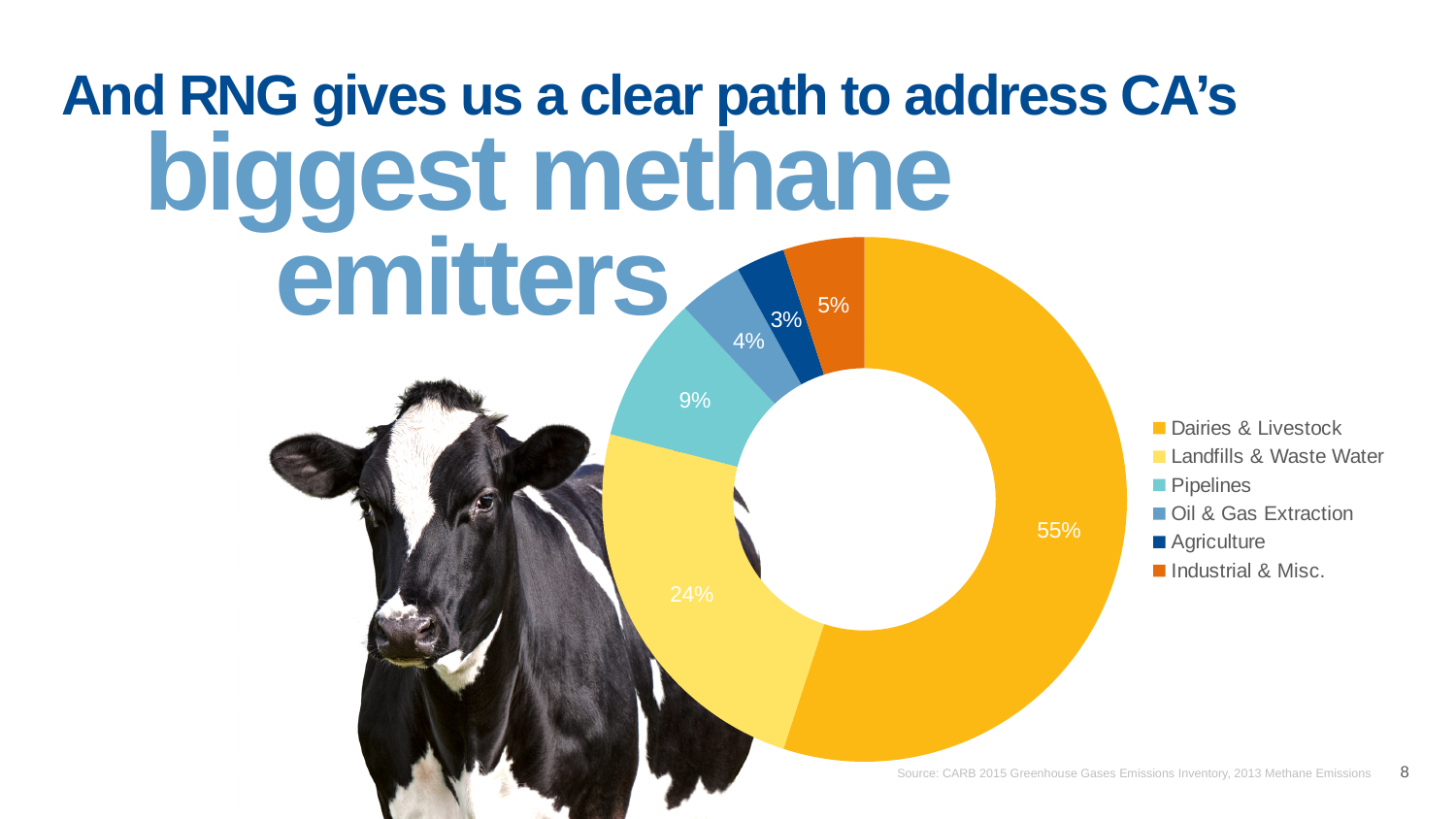
Which category has the smallest share of the chart? Agriculture What share of methane emissions comes from Dairies & Livestock? 55% What source is cited for the chart data? CARB 2015 Greenhouse Gases Emissions Inventory, 2013 Methane Emissions What is the difference in percentage points between Dairies & Livestock and Landfills & Waste Water? 31 What percentage is shown for Pipelines? 9% How many categories does the chart show? 6 What percentage is shown for Agriculture? 3% Which is larger, the share for Industrial & Misc. or the share for Oil & Gas Extraction? Industrial & Misc. What colour represents Pipelines in the chart? Light blue Which category has the largest share of the chart? Dairies & Livestock What percentage is shown for Landfills & Waste Water? 24% What kind of chart is shown on the slide? Doughnut (pie) chart